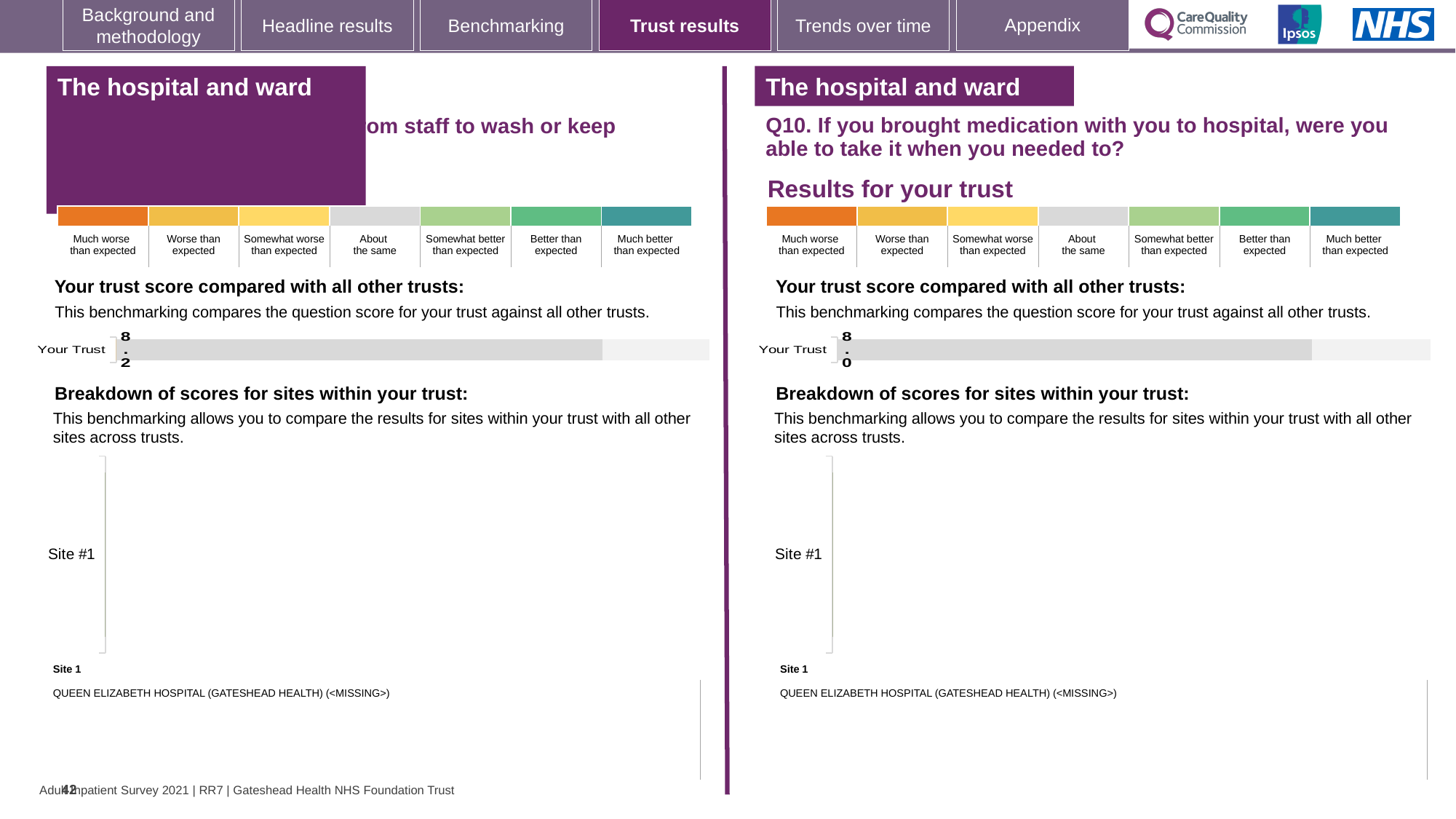
In the right panel (Q10), which hospital is listed as Site 1? QUEEN ELIZABETH HOSPITAL (GATESHEAD HEALTH) (<MISSING>) In the left panel, what is the score shown for Your Trust in the 'Your trust score compared with all other trusts' chart? 8.2 Which panel shows the higher Your Trust score, the left panel or the right panel (Q10)? Left panel In the right panel (Q10), how many sites are listed in the 'Breakdown of scores for sites within your trust' chart? 1 In the right panel (Q10), what is the score shown for Your Trust in the 'Your trust score compared with all other trusts' chart? 8.0 What is the difference between the Your Trust score in the left panel and the Your Trust score in the right panel (Q10)? 0.2 In the left panel, what is the label of the single bar in the 'Your trust score compared with all other trusts' chart? Your Trust How many rating categories are shown in the colour key above the right panel's (Q10) charts? 7 What kind of chart is used to show the Your Trust score in the right panel (Q10)? Bar chart